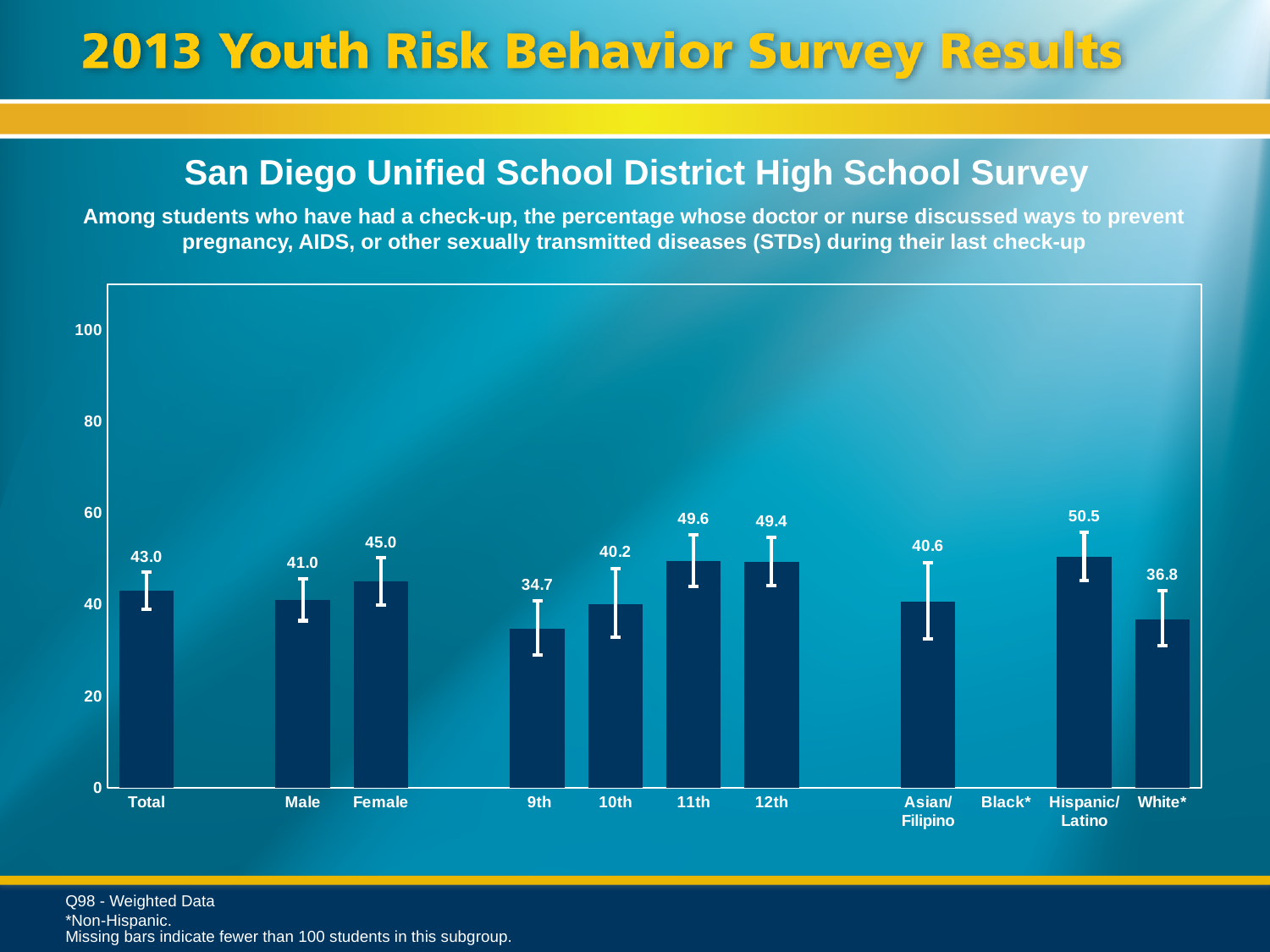
What is the value for Female? 45.0 How many bars are plotted on the chart? 10 What is the value for Total? 43.0 Which category has the lowest value among the bars shown? 9th What is the value for 9th grade? 34.7 Which category has the highest value? Hispanic/Latino Which category label has no bar plotted? Black* What is the difference between the Female and Male values? 4.0 What is the value for Hispanic/Latino? 50.5 Which is larger, the value for 10th or the value for 11th? 11th What kind of chart is shown? bar chart Is the value for White* greater or less than 40? less